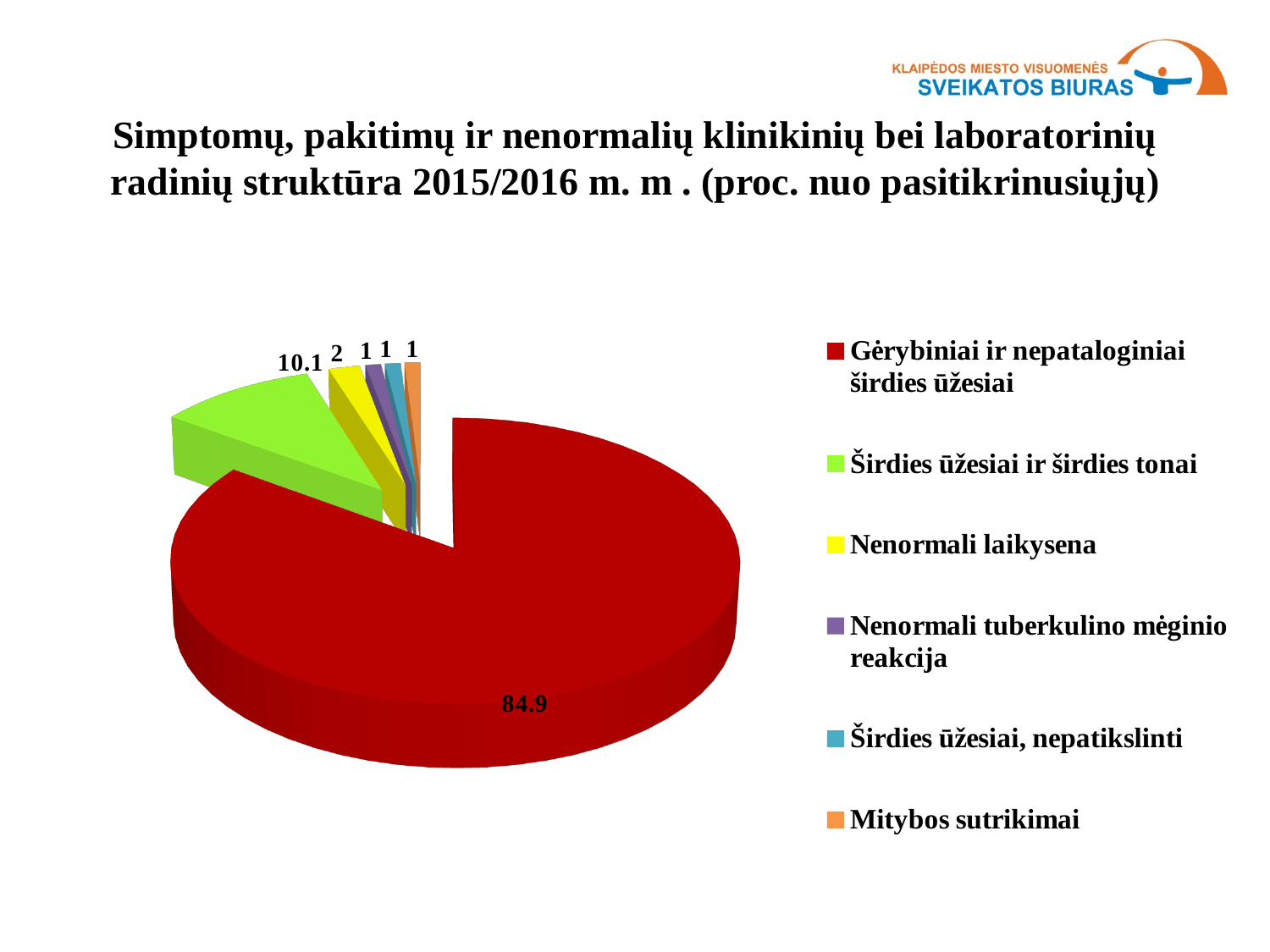
What is the value for Gėrybiniai ir nepatologiniai širdies ūžesiai? 84.9 How many slices does the pie chart have? 6 What colour is the slice for Širdies ūžesiai ir širdies tonai? green How many entries does the legend list? 6 What is the value for Mitybos sutrikimai? 1 What is the value for Nenormali laikysena? 2 What is the difference between the values for Širdies ūžesiai ir širdies tonai and Nenormali laikysena? 8.1 What type of chart is shown on the slide? pie chart Which is larger, the value for Nenormali laikysena or the value for Nenormali tuberkulino mėginio reakcija? Nenormali laikysena What is the value for Širdies ūžesiai ir širdies tonai? 10.1 Which category has the largest slice of the pie? Gėrybiniai ir nepatologiniai širdies ūžesiai What is the difference between the values for Gėrybiniai ir nepatologiniai širdies ūžesiai and Širdies ūžesiai ir širdies tonai? 74.8